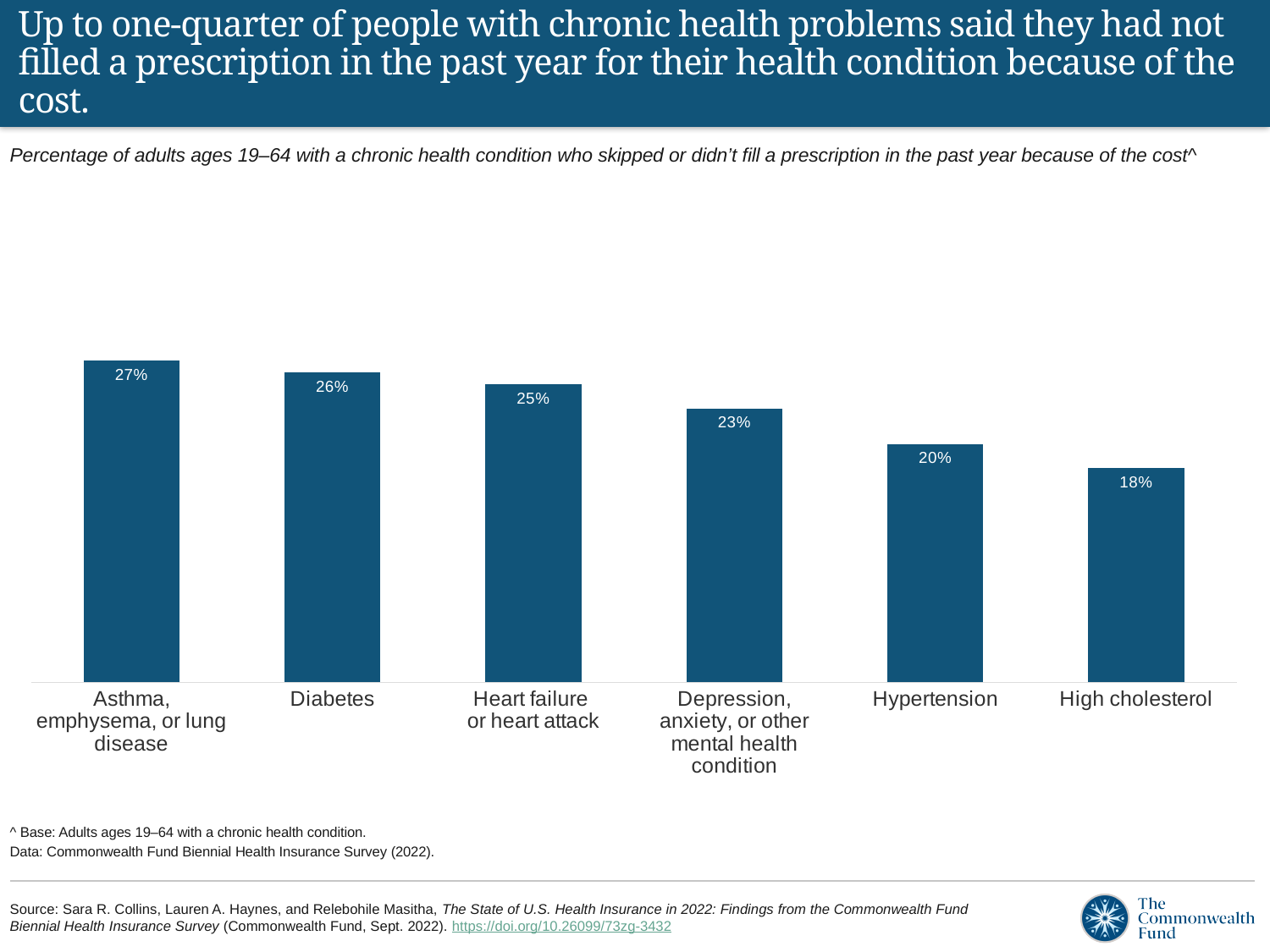
What is the difference in percentage points between Asthma, emphysema, or lung disease and High cholesterol? 9 percentage points Do the values rise or fall moving from left to right across the chart? Fall What percentage of adults with asthma, emphysema, or lung disease skipped or didn't fill a prescription because of the cost? 27% What is the value shown for Hypertension? 20% How many chronic health conditions are shown in the chart? 6 What kind of chart is shown on the slide? Bar chart Which is larger, the value for Diabetes or the value for Hypertension? Diabetes What is the value shown for Diabetes? 26% What is the value shown for High cholesterol? 18% Which chronic health condition has the lowest percentage? High cholesterol What is the difference between the values for Heart failure or heart attack and Depression, anxiety, or other mental health condition? 2 percentage points Which chronic health condition has the highest percentage of adults who skipped or didn't fill a prescription because of the cost? Asthma, emphysema, or lung disease